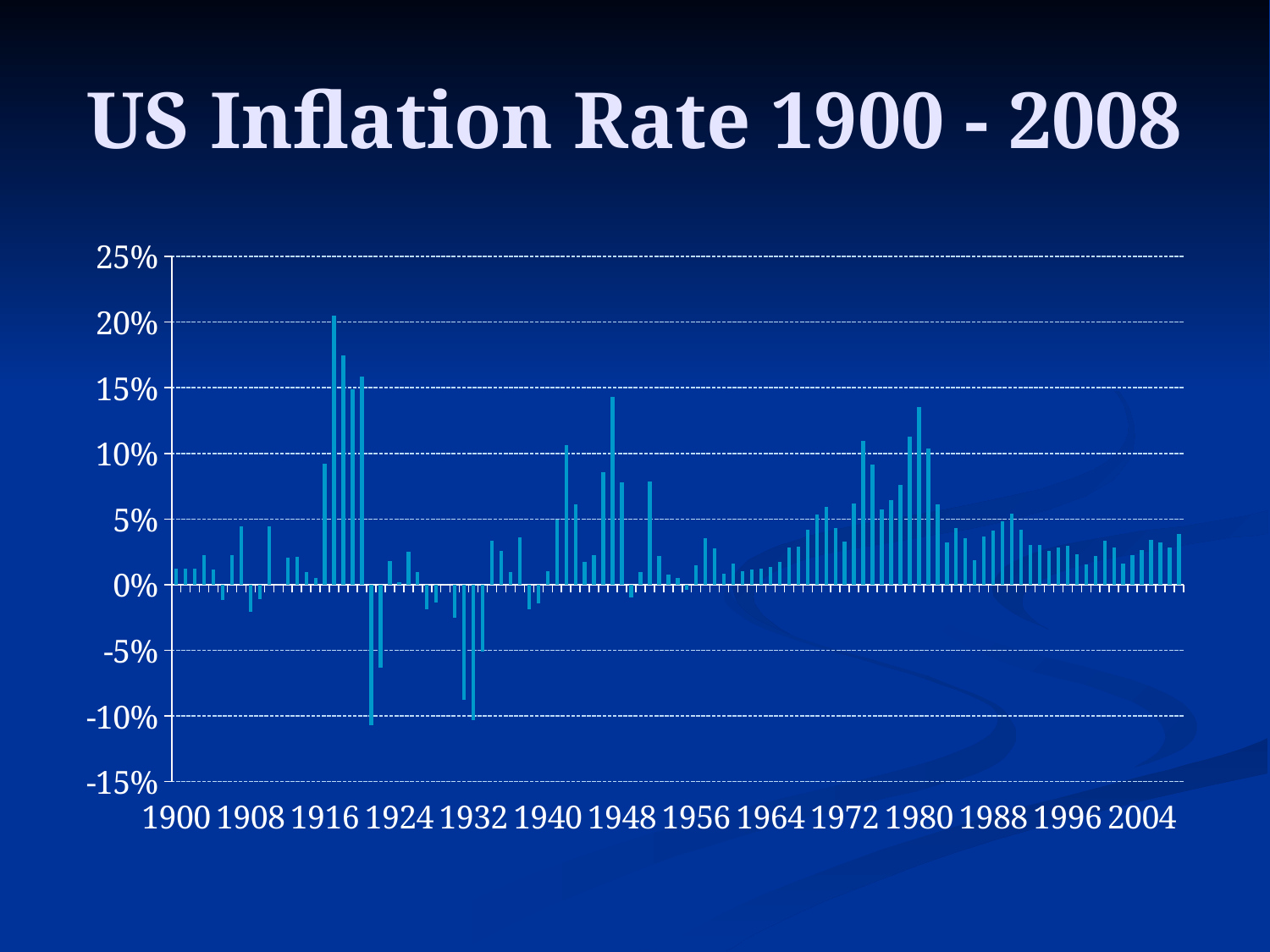
Is the value for 1920 greater or less than 10%? greater What is the highest value shown on the vertical axis? 25% Is the tallest bar on the chart greater or less than 15%? greater Is the value for 1932 greater or less than -5%? less Which year has the larger value, 1980 or 2004? 1980 Between 1980 and 1988, do the values generally rise or fall? fall What is the title of the chart? US Inflation Rate 1900 - 2008 What kind of chart is shown on the slide? bar chart